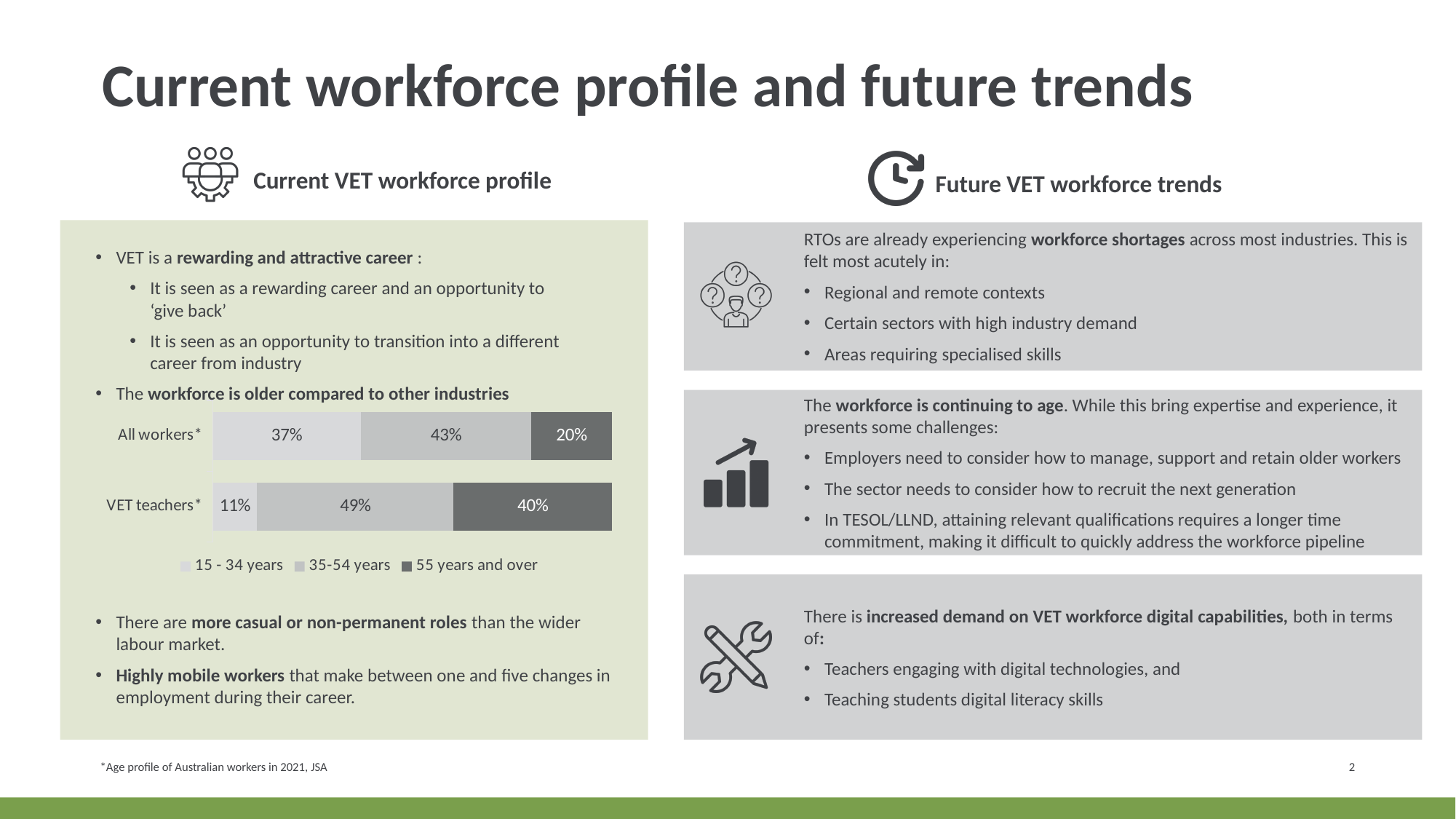
What is the difference between the 15 - 34 years share for All workers and for VET teachers? 26% What percentage of VET teachers are aged 55 years and over? 40% What percentage of all workers are aged 55 years and over? 20% What is the difference in the 55 years and over share between VET teachers and All workers? 20% What type of chart is used to show the age profile? Stacked bar chart How many series does the chart legend list? 3 What percentage of VET teachers are aged 35-54 years? 49% How many categories (bars) are shown in the chart? 2 Which age group makes up the largest share of VET teachers? 35-54 years Which age group makes up the smallest share of VET teachers? 15 - 34 years Which category has the larger share of workers aged 15 - 34 years, All workers or VET teachers? All workers What percentage of all workers are aged 15 - 34 years? 37%